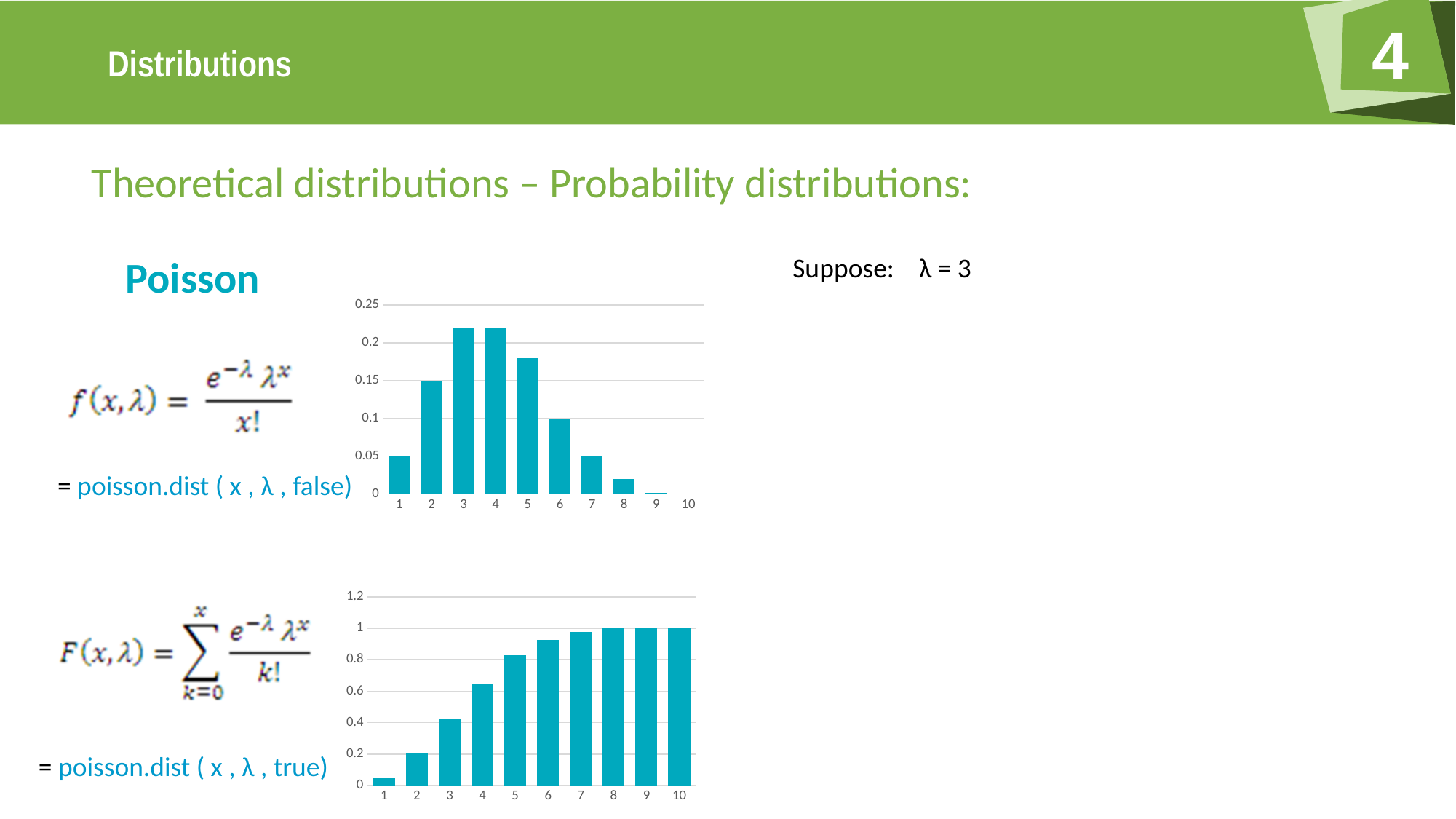
In the top chart, is the value for category 8 greater or less than 0.05? less How many categories are shown on the x axis of the top chart? 10 How many categories are shown on the x axis of the bottom chart? 10 What is the highest value labelled on the y axis of the bottom chart? 1.2 What kind of chart is the top chart on the slide? bar chart In the bottom chart, do the values rise or fall as you move from category 1 to category 10? rise In the top chart, which has the larger value, category 2 or category 7? category 2 In the top chart, is the value for category 5 greater or less than 0.2? less In the bottom chart, which has the larger value, category 2 or category 5? category 5 In the bottom chart, is the value for category 3 greater or less than 0.6? less